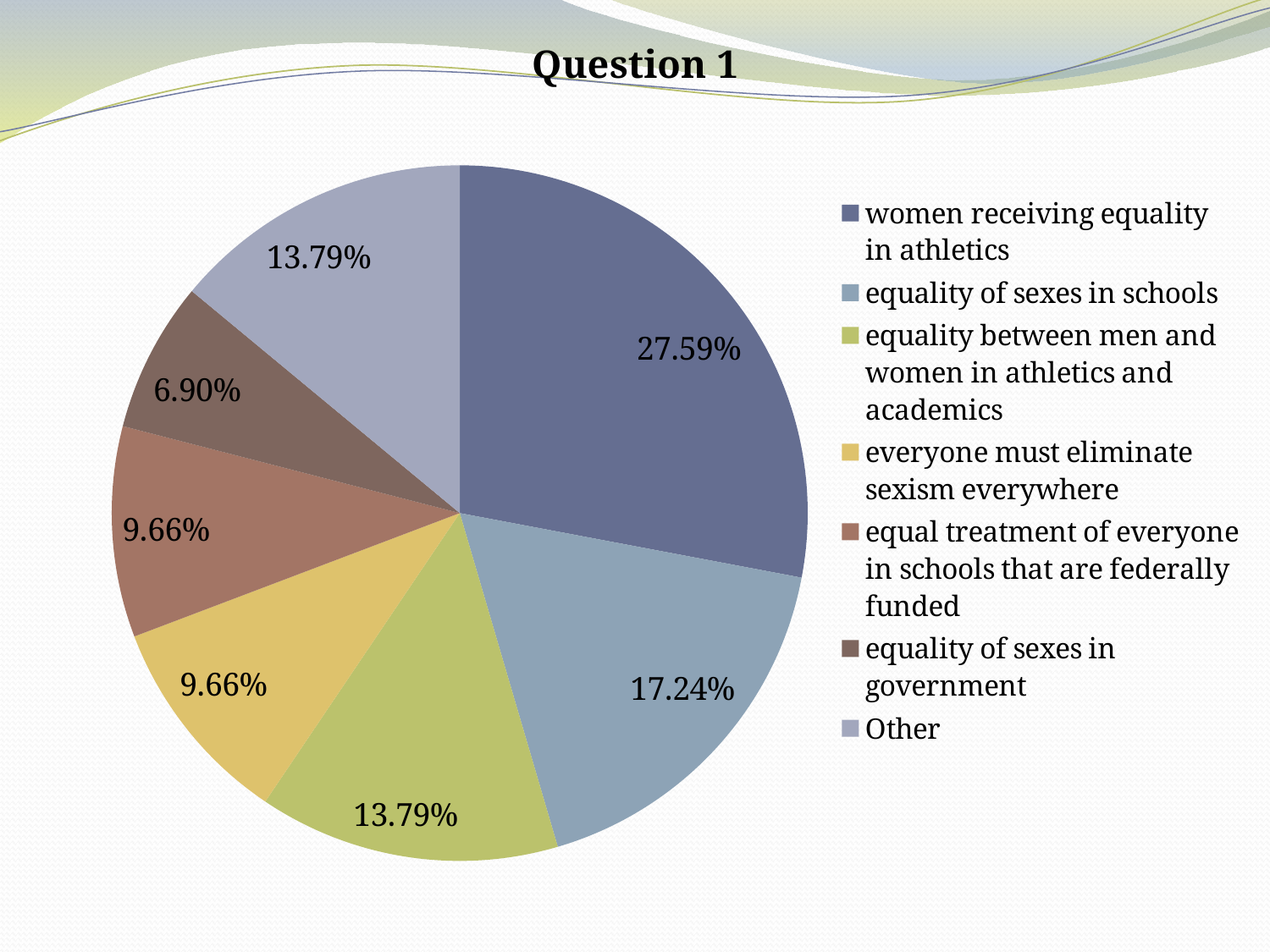
What is the title of the slide containing the pie chart? Question 1 Which is larger: the share for "equality of sexes in schools" or the share for "Other"? equality of sexes in schools Which category has the smallest slice of the pie? equality of sexes in government What share of the pie is labelled for "women receiving equality in athletics"? 27.59% What share of the pie is labelled for "everyone must eliminate sexism everywhere"? 9.66% What share of the pie is labelled for "equality of sexes in government"? 6.90% What kind of chart is shown on the slide? pie chart What share of the pie is labelled for "Other"? 13.79% Which category has the largest slice of the pie? women receiving equality in athletics What is the difference between the share for "women receiving equality in athletics" and the share for "equality of sexes in schools"? 10.35% What share of the pie is labelled for "equality of sexes in schools"? 17.24% How many slices does the pie chart have? 7